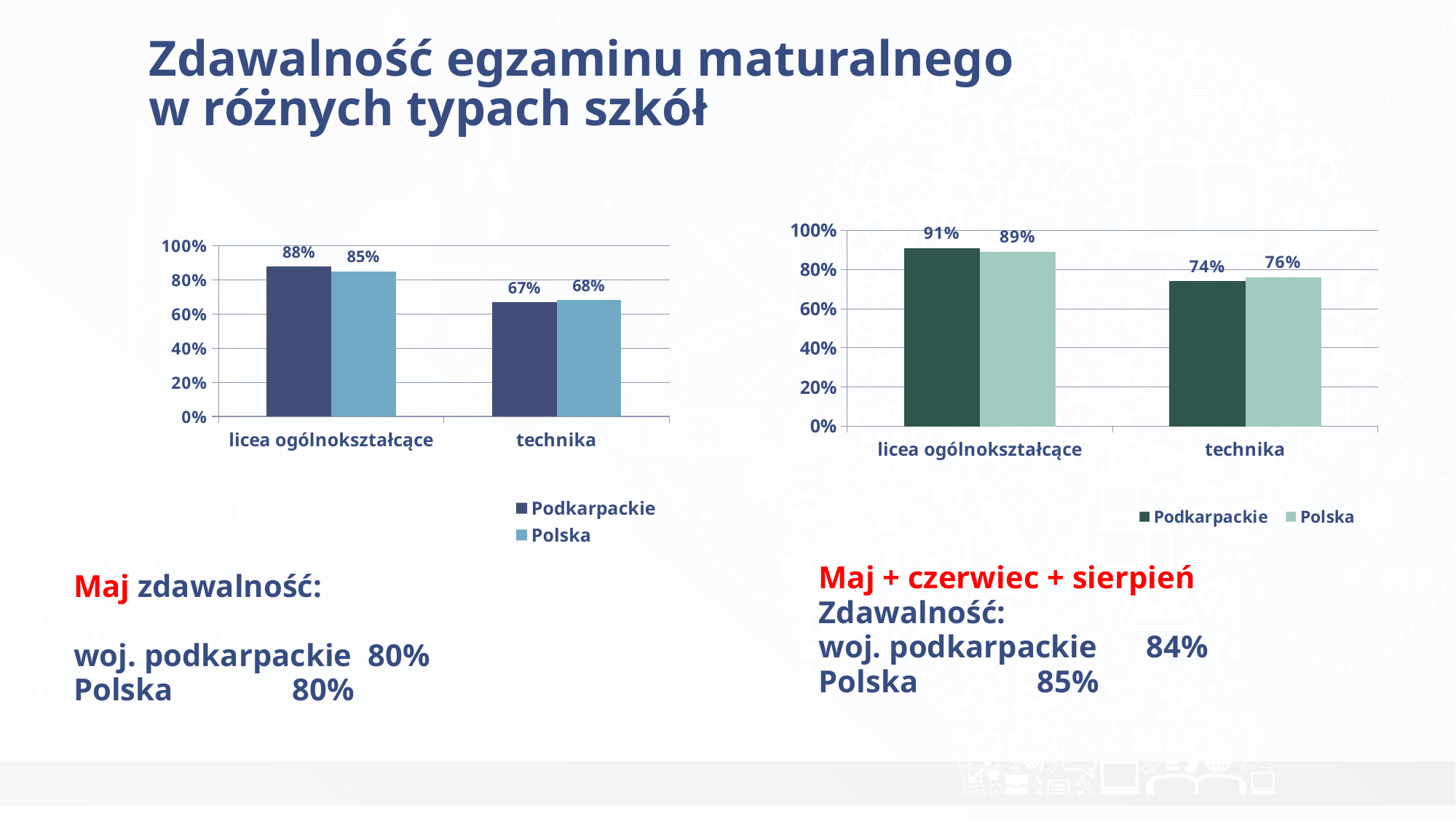
In the left chart, what is the value for Polska for technika? 68% In the left chart, what is the difference between the Podkarpackie and Polska values for licea ogólnokształcące? 3% In the right chart, what is the value for Podkarpackie for licea ogólnokształcące? 91% In the left chart, which is larger for technika: Podkarpackie or Polska? Polska In the right chart, what is the difference between the Polska and Podkarpackie values for technika? 2% What kind of chart is the right chart? bar chart In the right chart, what is the value for Polska for technika? 76% In the right chart, which category has the highest Podkarpackie value? licea ogólnokształcące In the left chart, which category has the lowest Podkarpackie value? technika In the left chart, what is the value for Podkarpackie for licea ogólnokształcące? 88% How many series does the legend of the right chart list? 2 How many categories are shown on the x axis of the left chart? 2